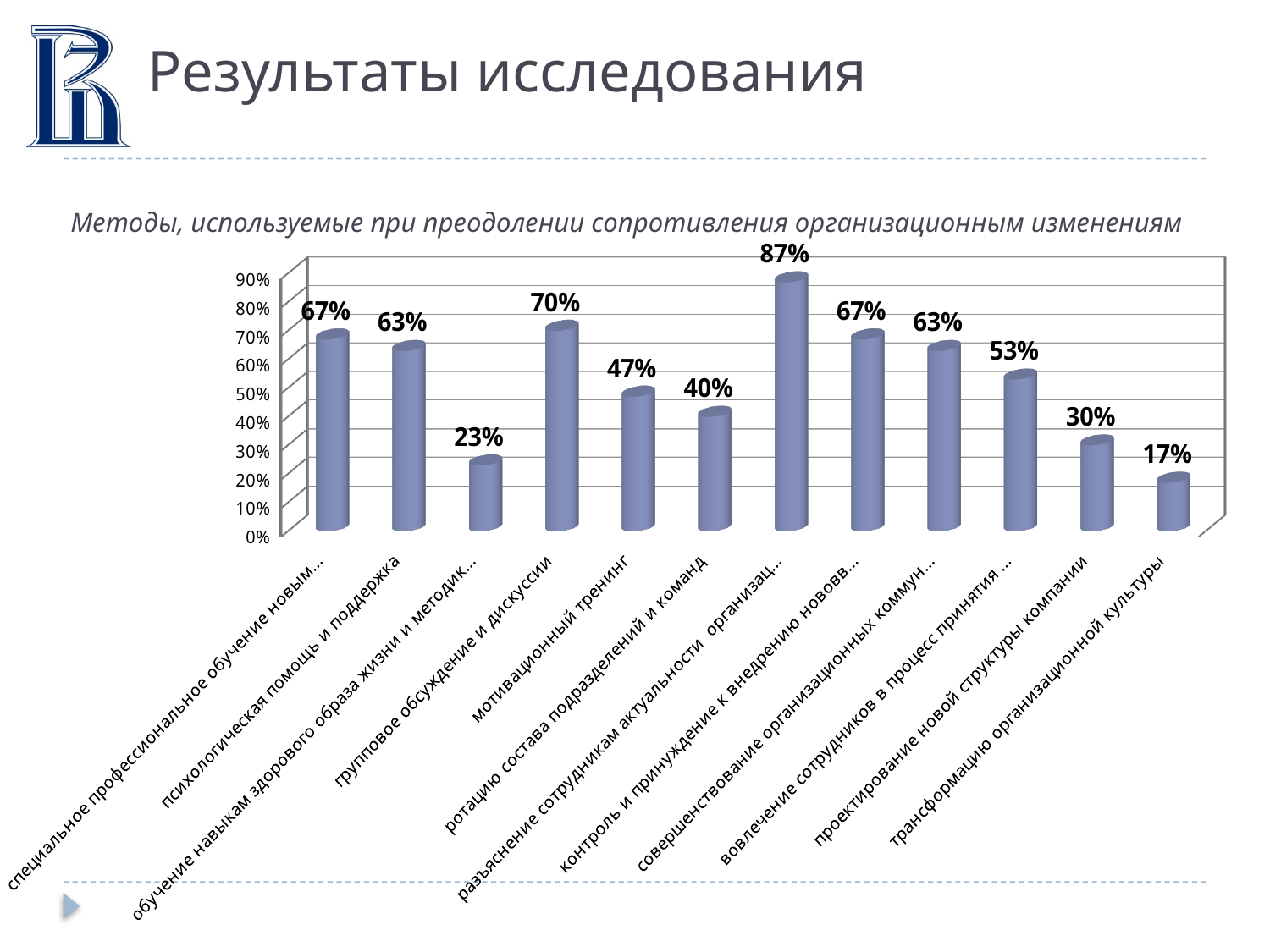
Which category has the lowest value? трансформацию организационной культуры What is the title of the chart? Методы, используемые при преодолении сопротивления организационным изменениям What type of chart is shown on the slide? bar chart What is the difference between the values for "психологическая помощь и поддержка" and "трансформацию организационной культуры"? 46% What is the value for "психологическая помощь и поддержка"? 63% What is the value for "мотивационный тренинг"? 47% Which is larger: the value for "ротацию состава подразделений и команд" or the value for "проектирование новой структуры компании"? ротацию состава подразделений и команд What is the value for "проектирование новой структуры компании"? 30% What is the highest value shown in the chart? 87% What is the difference between the values for "групповое обсуждение и дискуссии" and "мотивационный тренинг"? 23% How many categories are plotted in the chart? 12 What is the value for "групповое обсуждение и дискуссии"? 70%